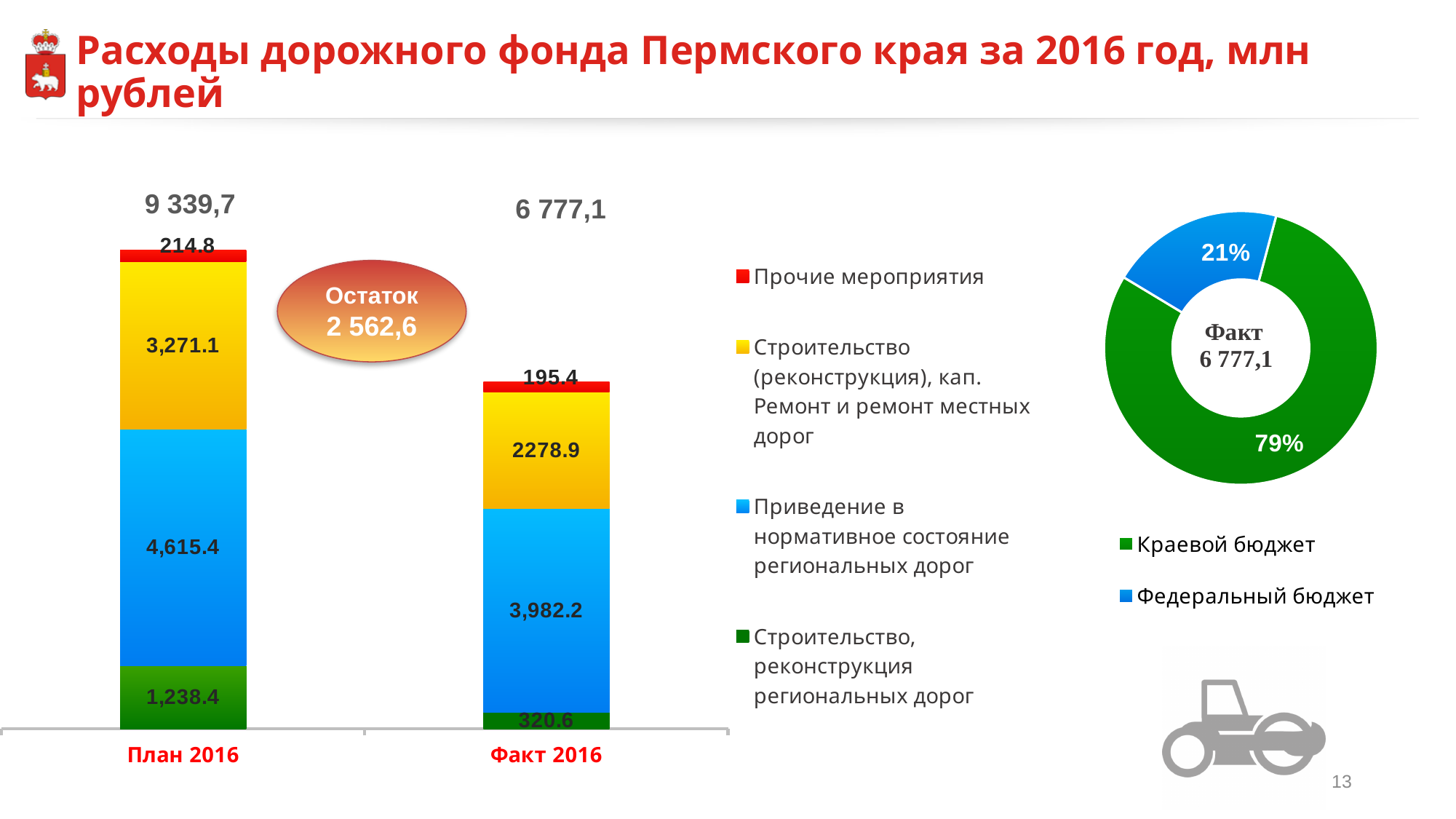
In the stacked bar chart on the left, what is the total shown above the План 2016 bar? 9 339,7 In the stacked bar chart on the left, what is the difference between the 'Приведение в нормативное состояние региональных дорог' values for План 2016 and Факт 2016? 633.2 In the stacked bar chart on the left, what is the value of the 'Строительство, реконструкция региональных дорог' segment for Факт 2016? 320.6 In the stacked bar chart on the left, what is the value of the 'Прочие мероприятия' segment for План 2016? 214.8 In the stacked bar chart on the left, which segment is the largest in the Факт 2016 bar? Приведение в нормативное состояние региональных дорог What type of chart is shown on the right side of the slide? Doughnut chart In the stacked bar chart on the left, which is larger: the 'Строительство (реконструкция), кап. Ремонт и ремонт местных дорог' value for План 2016 or for Факт 2016? План 2016 How many series does the legend of the stacked bar chart on the left list? 4 In the stacked bar chart on the left, what is the total shown above the Факт 2016 bar? 6 777,1 In the stacked bar chart on the left, which segment is the smallest in the План 2016 bar? Прочие мероприятия In the stacked bar chart on the left, what is the value of the 'Приведение в нормативное состояние региональных дорог' segment for План 2016? 4,615.4 In the doughnut chart on the right, what share does 'Краевой бюджет' have? 79%